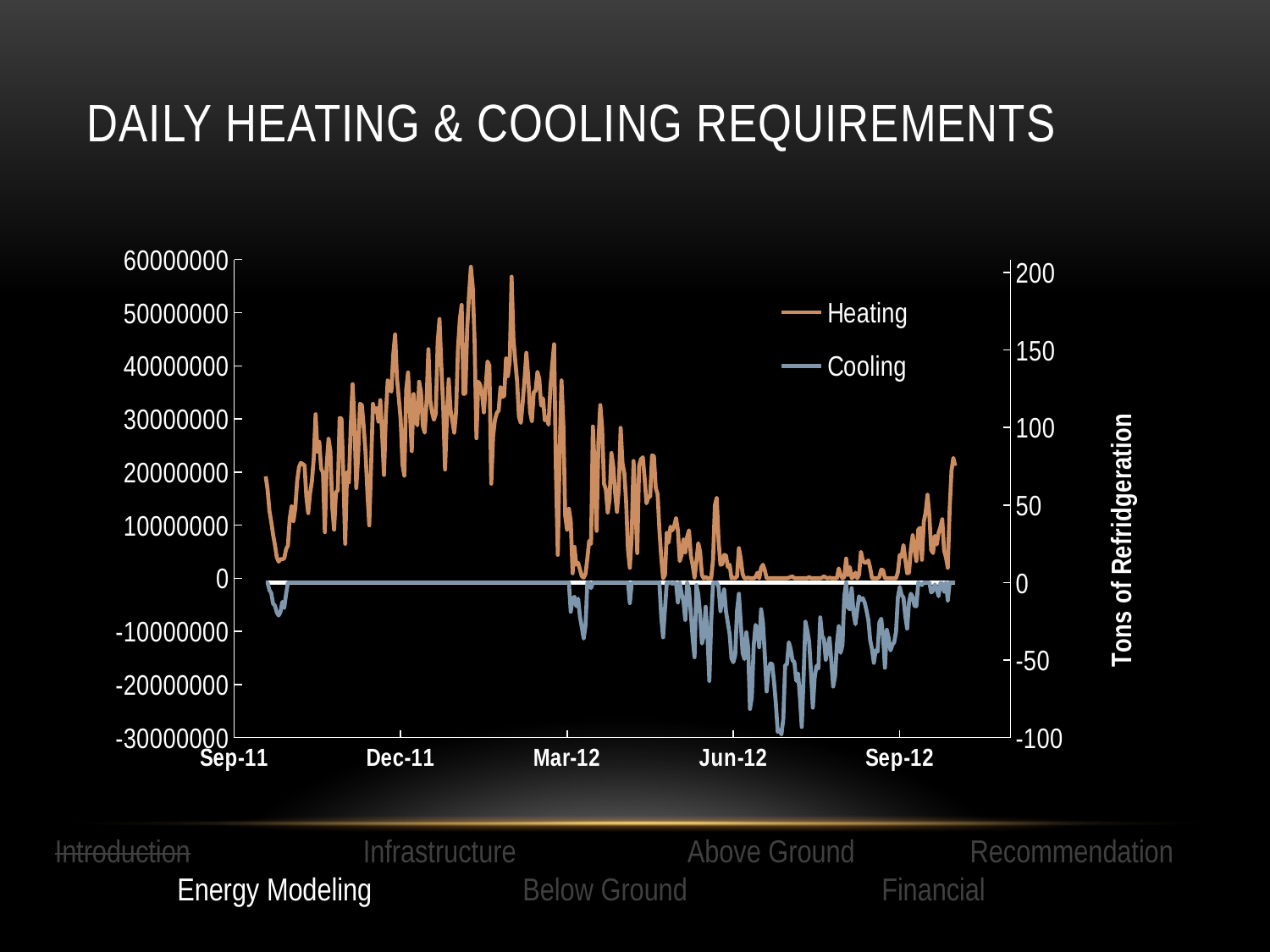
What are the two series named in the legend? Heating and Cooling How many date labels are shown along the x axis? 5 What is the highest tick value shown on the right-hand axis? 200 Is the peak Heating value (around Jan-12) greater or less than 50000000 on the left axis? greater Does the Heating series rise or fall between Sep-12 and the end of the chart? rise Is the Heating value around Jul-12 greater or less than 10000000 on the left axis? less What is the title of the chart? Daily Heating & Cooling Requirements Which series has the higher values around Dec-11, Heating or Cooling? Heating How many series does the legend list? 2 Does the Heating series rise or fall between Mar-12 and Jun-12? fall Which series has the higher values around Jul-12, Heating or Cooling? Heating What kind of chart is shown on the slide? line chart